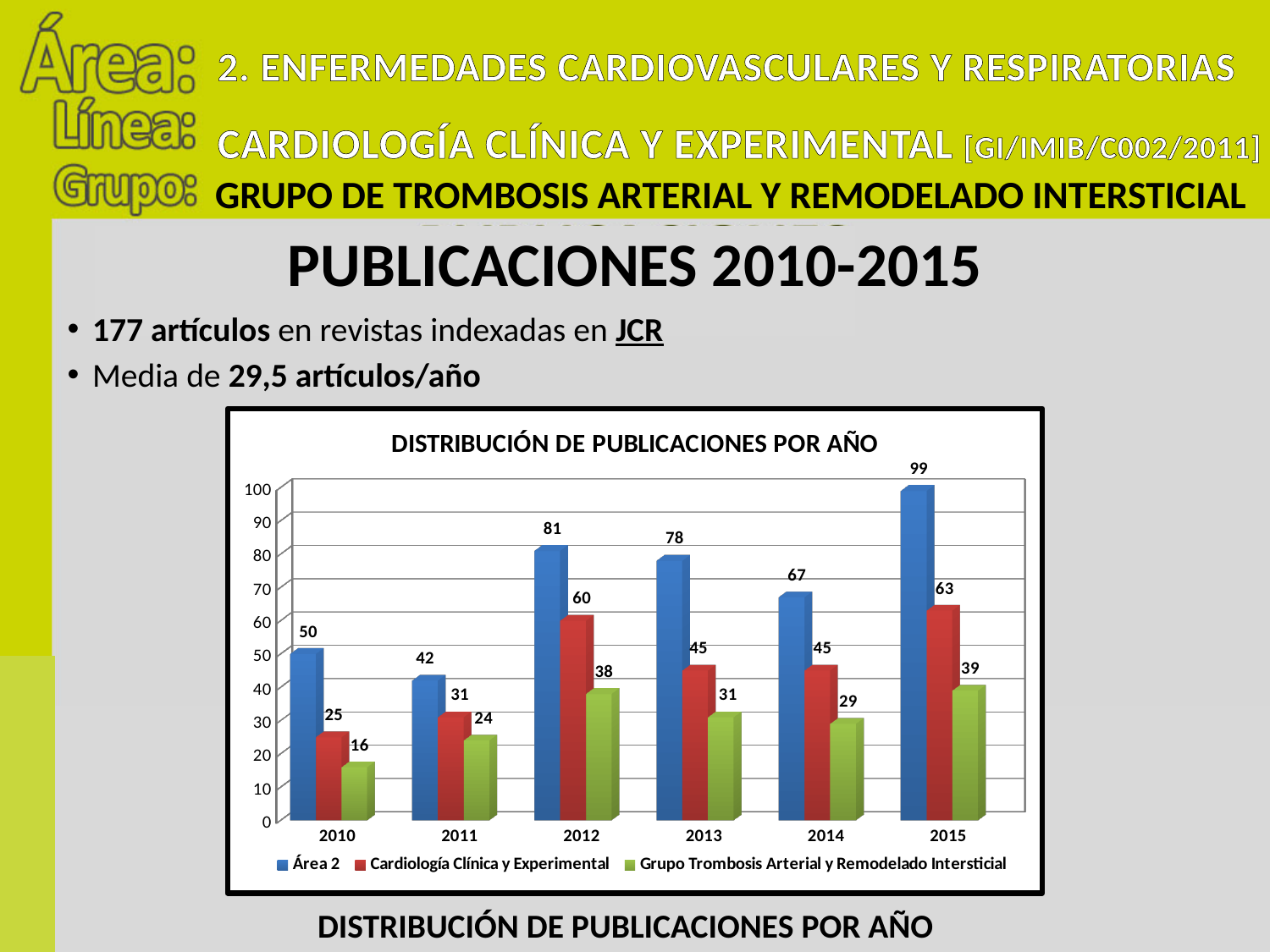
In which year is the value for Grupo Trombosis Arterial y Remodelado Intersticial lowest? 2010 How many years are shown on the x axis? 6 What is the value for Área 2 in 2015? 99 What is the title of the chart? DISTRIBUCIÓN DE PUBLICACIONES POR AÑO What kind of chart is shown? Bar chart Which is larger: the Cardiología Clínica y Experimental value in 2013 or in 2014? They are equal (45) What is the value for Grupo Trombosis Arterial y Remodelado Intersticial in 2010? 16 In which year is the value for Área 2 highest? 2015 What is the value for Cardiología Clínica y Experimental in 2012? 60 Which is larger: the Grupo Trombosis Arterial y Remodelado Intersticial value in 2012 or in 2015? 2015 What is the difference between the Área 2 value and the Cardiología Clínica y Experimental value in 2015? 36 How many series does the legend list? 3